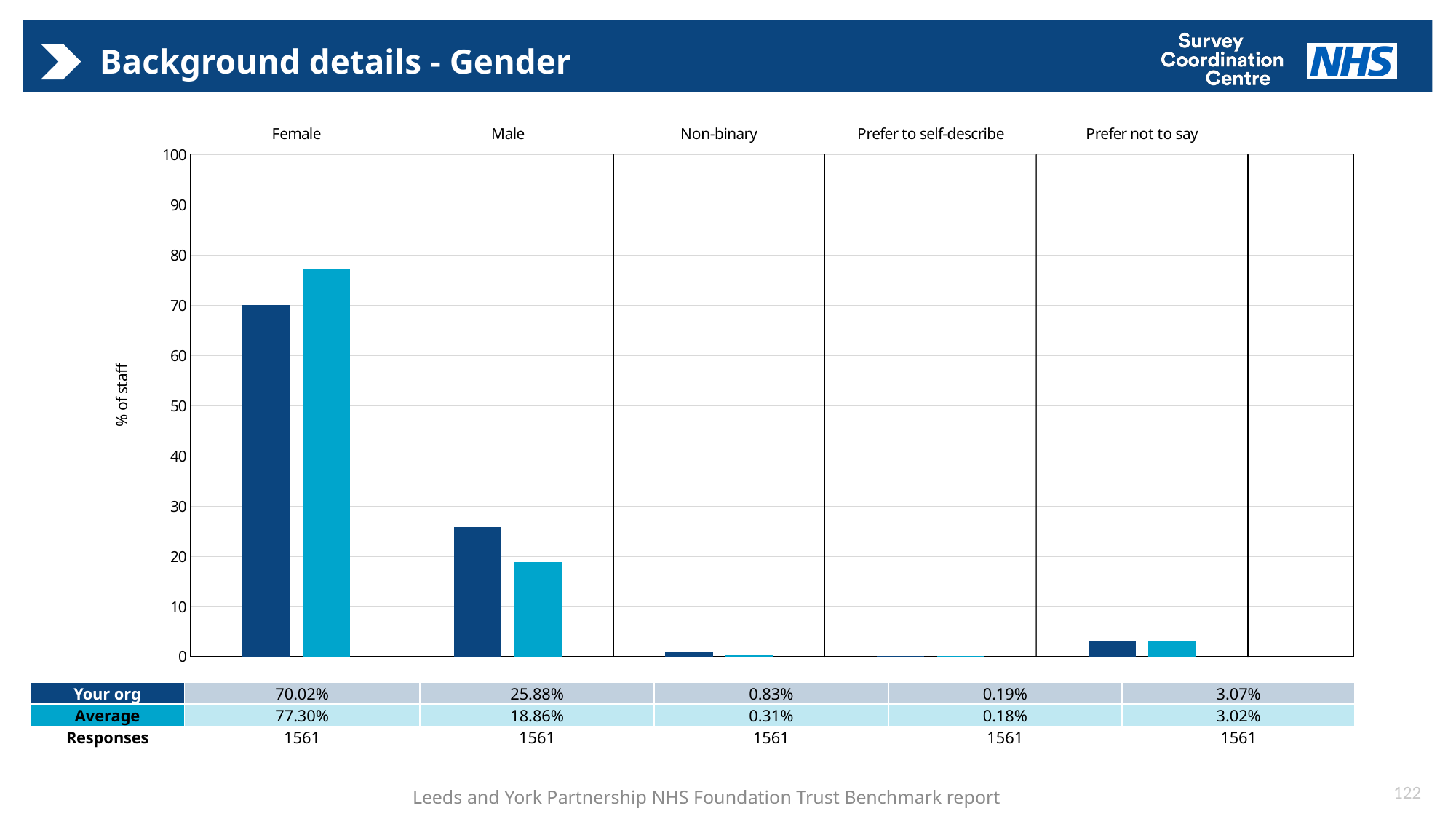
What type of chart is shown on the slide? bar chart What is the 'Your org' value for Female? 70.02% What is the difference between the Average and 'Your org' values for Female? 7.28% How many gender categories are shown on the chart? 5 What is the Average value for Non-binary? 0.31% Which category has the lowest Average value? Prefer to self-describe How many responses are recorded for the Female category? 1561 Which category has the highest 'Your org' value? Female Is the 'Your org' value for Male greater or less than 30? less Which is larger for Male: the 'Your org' value or the Average value? Your org What is the Average value for Male? 18.86% What is the 'Your org' value for Prefer not to say? 3.07%